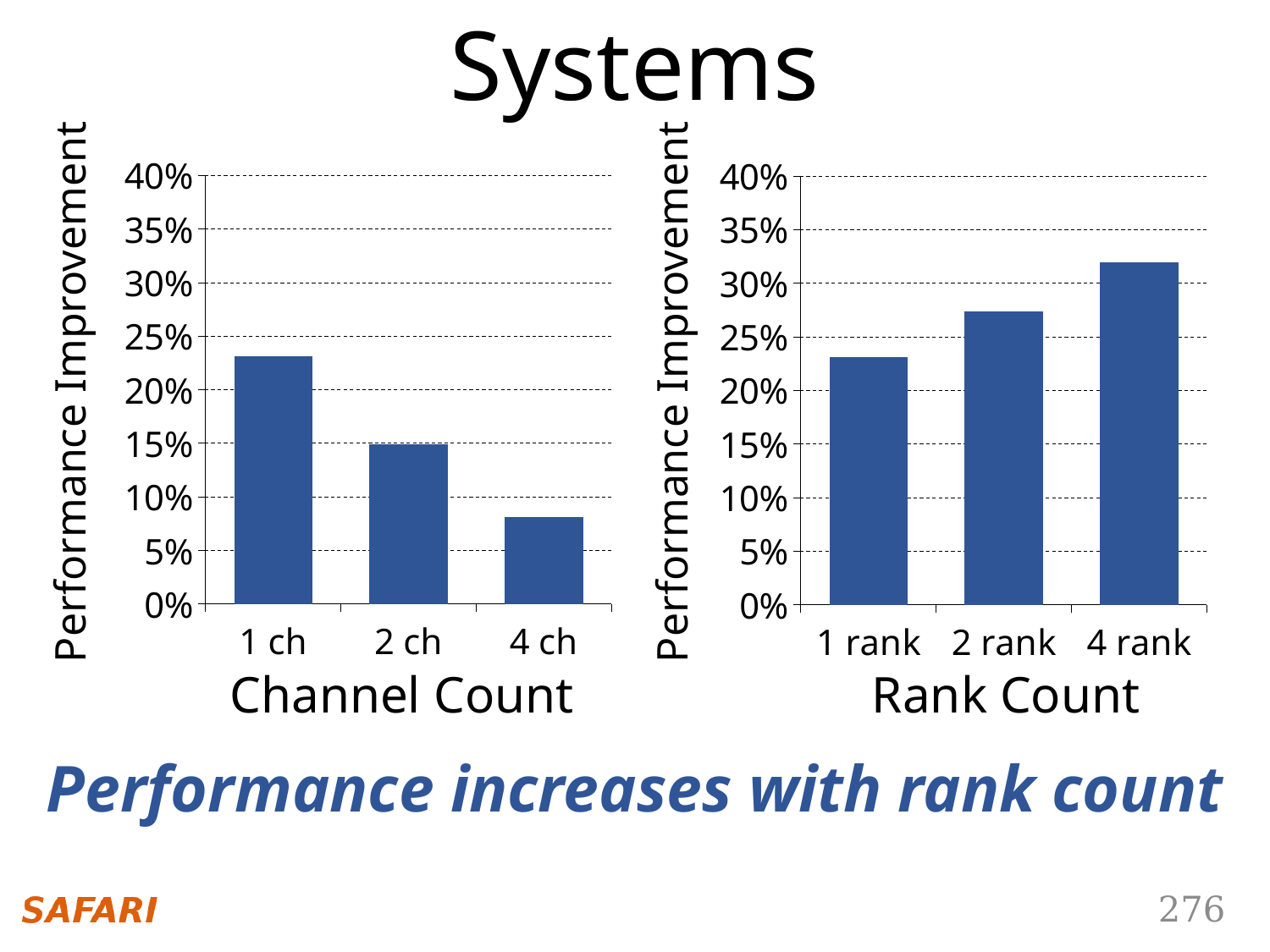
In the Rank Count chart, which rank count has the highest performance improvement? 4 rank In the Channel Count chart, do the values rise or fall as channel count increases along the x axis? fall In the Rank Count chart, is the value for 4 rank greater or less than 30%? greater In the Channel Count chart, which is larger, the value for 2 ch or the value for 4 ch? 2 ch In the Channel Count chart, is the value for 1 ch greater or less than 20%? greater In the Channel Count chart, is the value for 4 ch greater or less than 10%? less In the Channel Count chart, which channel count has the highest performance improvement? 1 ch How many bars are in the Rank Count chart? 3 In the Rank Count chart, do the values rise or fall as rank count increases along the x axis? rise In the Rank Count chart, which rank count has the lowest performance improvement? 1 rank In the Channel Count chart, which channel count has the lowest performance improvement? 4 ch